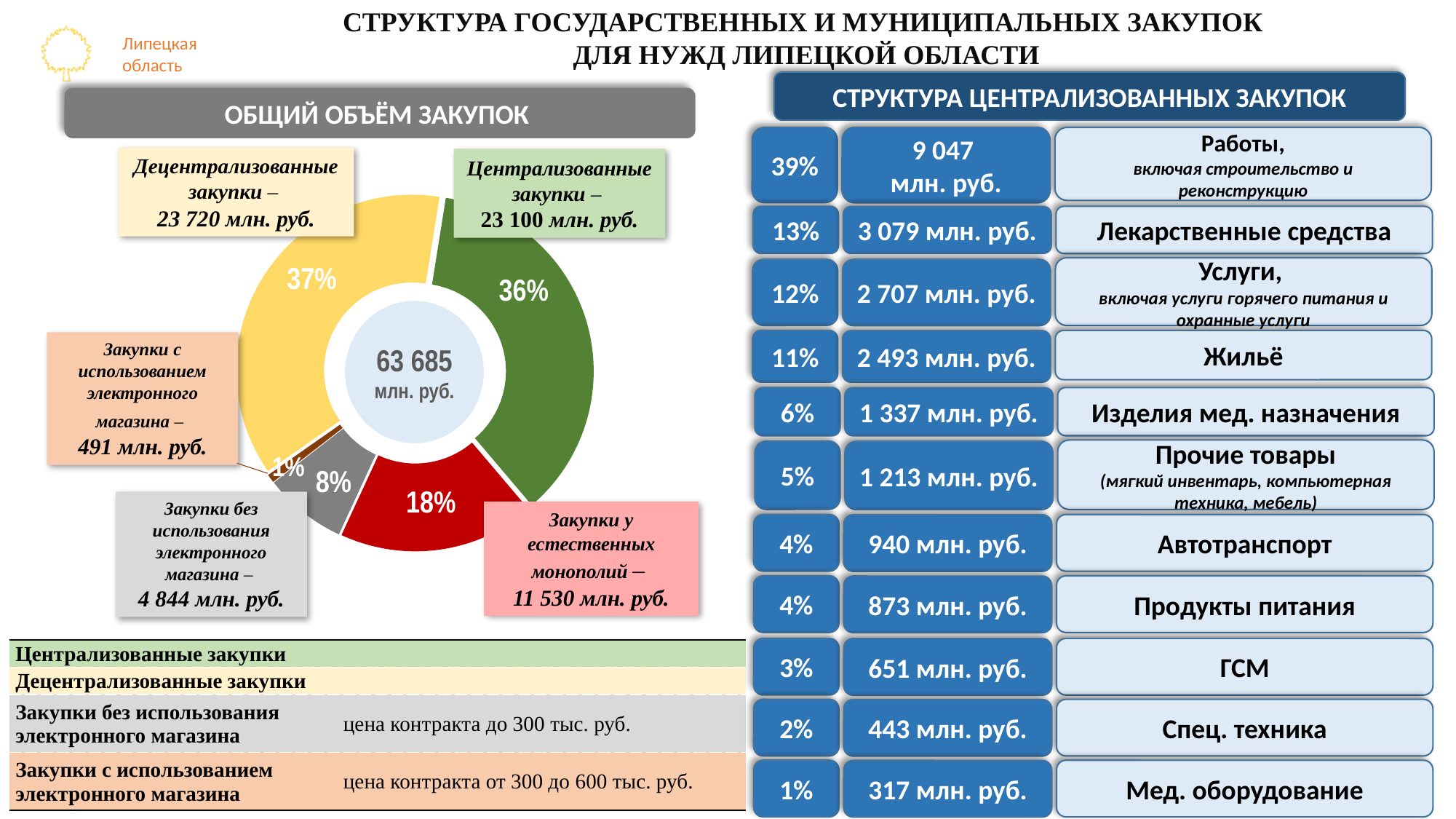
How many slices does the "ОБЩИЙ ОБЪЁМ ЗАКУПОК" chart have? 5 In the "ОБЩИЙ ОБЪЁМ ЗАКУПОК" chart, what is the value for "Закупки с использованием электронного магазина"? 491 млн. руб. What kind of chart is shown under the heading "ОБЩИЙ ОБЪЁМ ЗАКУПОК"? Pie (donut) chart In the "ОБЩИЙ ОБЪЁМ ЗАКУПОК" chart, what is the difference in млн. руб. between "Децентрализованные закупки" and "Централизованные закупки"? 620 млн. руб. In the "ОБЩИЙ ОБЪЁМ ЗАКУПОК" chart, what share of the total do "Децентрализованные закупки" account for? 37% What total value is shown in the centre of the "ОБЩИЙ ОБЪЁМ ЗАКУПОК" chart? 63 685 млн. руб. In the "ОБЩИЙ ОБЪЁМ ЗАКУПОК" chart, which is larger: "Закупки у естественных монополий" or "Закупки без использования электронного магазина"? Закупки у естественных монополий In the "ОБЩИЙ ОБЪЁМ ЗАКУПОК" chart, what is the value for "Закупки без использования электронного магазина"? 4 844 млн. руб. In the "ОБЩИЙ ОБЪЁМ ЗАКУПОК" chart, what is the value for "Закупки у естественных монополий"? 11 530 млн. руб. In the "ОБЩИЙ ОБЪЁМ ЗАКУПОК" chart, which category has the largest share? Децентрализованные закупки In the "ОБЩИЙ ОБЪЁМ ЗАКУПОК" chart, which category has the smallest share? Закупки с использованием электронного магазина In the "ОБЩИЙ ОБЪЁМ ЗАКУПОК" chart, what share of the total do "Централизованные закупки" account for? 36%